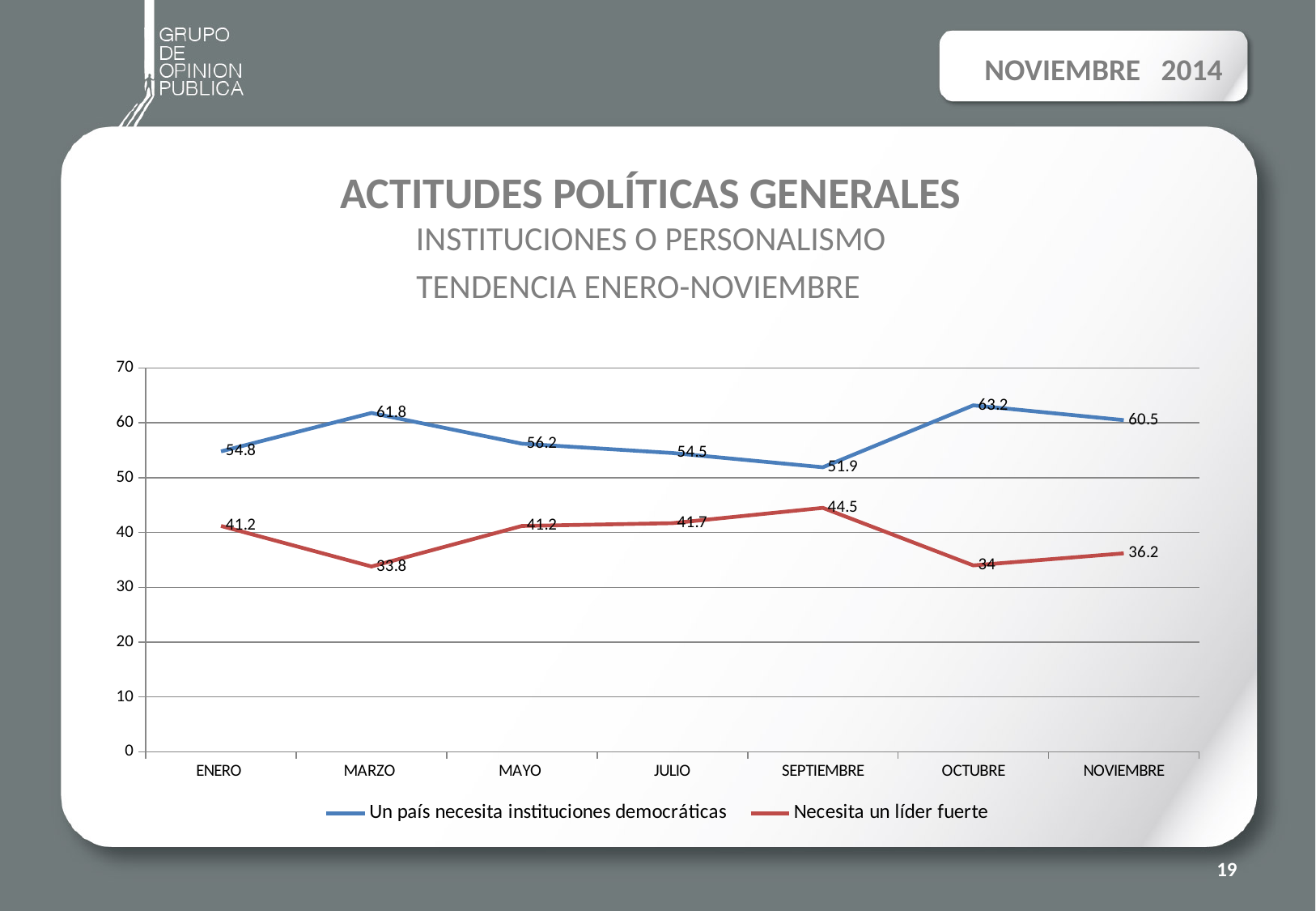
How many months are shown on the x axis? 7 What is the value for 'Un país necesita instituciones democráticas' in OCTUBRE? 63.2 What is the value for 'Necesita un líder fuerte' in MARZO? 33.8 How many series does the legend list? 2 What kind of chart is shown on the slide? line chart Is the value for 'Necesita un líder fuerte' in OCTUBRE greater or less than 40? less What is the difference between the two series in NOVIEMBRE? 24.3 What is the value for 'Necesita un líder fuerte' in NOVIEMBRE? 36.2 In which month is 'Un país necesita instituciones democráticas' lowest? SEPTIEMBRE In which month is 'Necesita un líder fuerte' highest? SEPTIEMBRE Which series has the higher value in ENERO? Un país necesita instituciones democráticas Does 'Un país necesita instituciones democráticas' rise or fall from OCTUBRE to NOVIEMBRE? fall